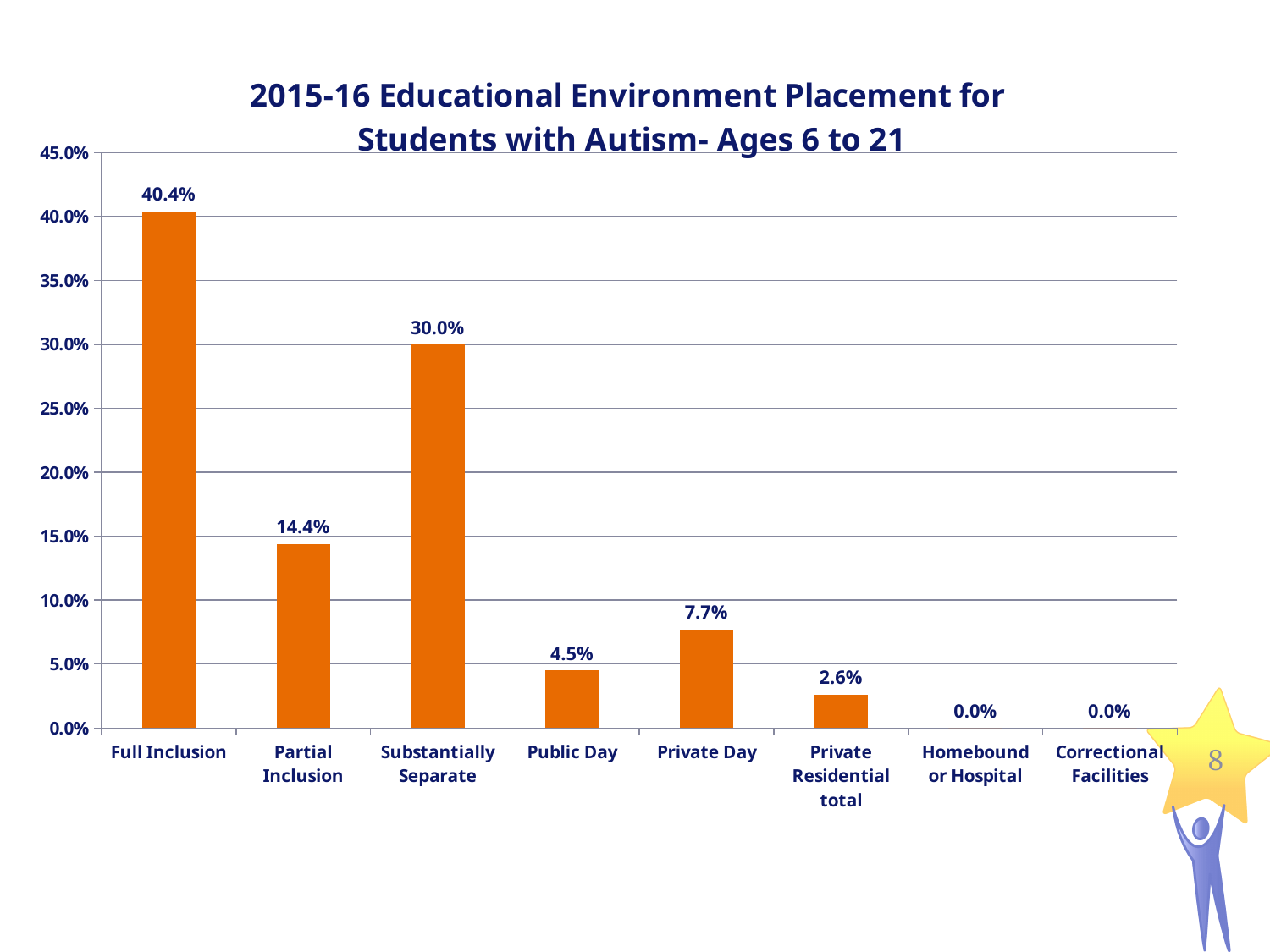
How many categories have a value of 0.0%? 2 How many categories are shown on the x axis? 8 What is the value for Substantially Separate? 30.0% Which is larger, Private Day or Public Day? Private Day What kind of chart is this? bar chart What is the title of the chart? 2015-16 Educational Environment Placement for Students with Autism- Ages 6 to 21 Is the value for Partial Inclusion greater or less than 10.0%? greater What is the value for Private Residential total? 2.6% What is the difference between Partial Inclusion and Public Day? 9.9% What is the value for Full Inclusion? 40.4% Which category has the highest value? Full Inclusion What is the difference between Full Inclusion and Substantially Separate? 10.4%